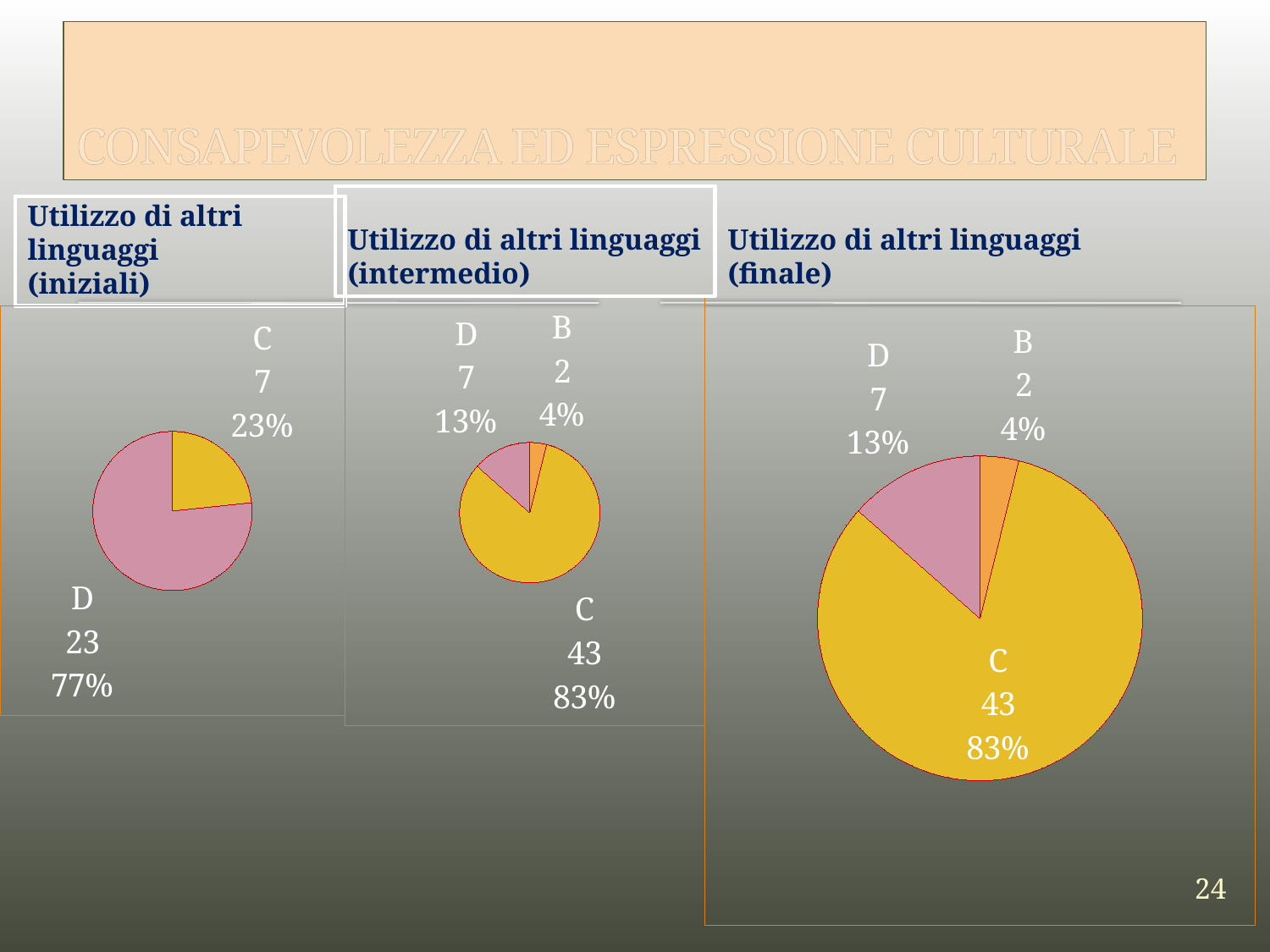
In the 'Utilizzo di altri linguaggi (iniziali)' chart, what is the difference between the values for D and C? 16 In the 'Utilizzo di altri linguaggi (iniziali)' chart, what share of the pie does C have? 23% In the 'Utilizzo di altri linguaggi (finale)' chart, which is larger, C or D? C How many charts are shown on the slide? 3 How many categories are shown in the 'Utilizzo di altri linguaggi (intermedio)' chart? 3 In the 'Utilizzo di altri linguaggi (intermedio)' chart, what share of the pie does D have? 13% In the 'Utilizzo di altri linguaggi (intermedio)' chart, what is the value for C? 43 In the 'Utilizzo di altri linguaggi (finale)' chart, what share of the pie does B have? 4% In the 'Utilizzo di altri linguaggi (iniziali)' chart, which category is the largest? D What kind of chart is the 'Utilizzo di altri linguaggi (finale)' chart? Pie chart In the 'Utilizzo di altri linguaggi (intermedio)' chart, which category is the smallest? B In the 'Utilizzo di altri linguaggi (iniziali)' chart, what is the value for D? 23